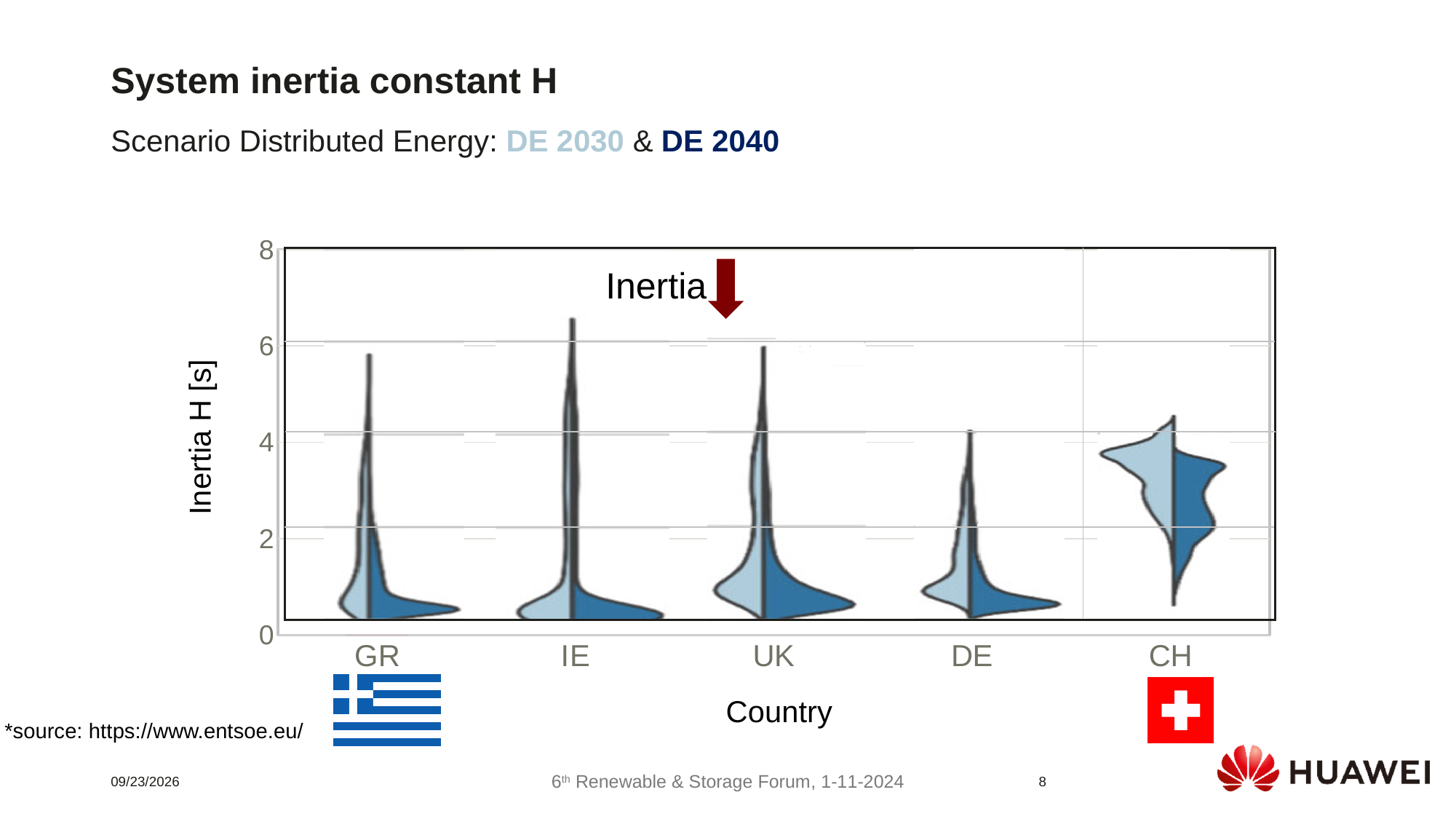
Which country has the highest maximum inertia H value in the chart? IE Which has the higher maximum inertia H value, IE or DE? IE Is the maximum inertia H value for CH greater or less than 6? less How many countries are shown on the x axis of the chart? 5 Is the maximum inertia H value for IE greater or less than 6? greater What kind of chart is shown on the slide? Violin plot Which country's inertia H distribution is concentrated at the highest values, between 2 and 4 s? CH How many scenarios are compared in the chart? 2 Is the maximum inertia H value for UK greater or less than 4? greater What is the label of the x axis? Country What is the label of the y axis? Inertia H [s]